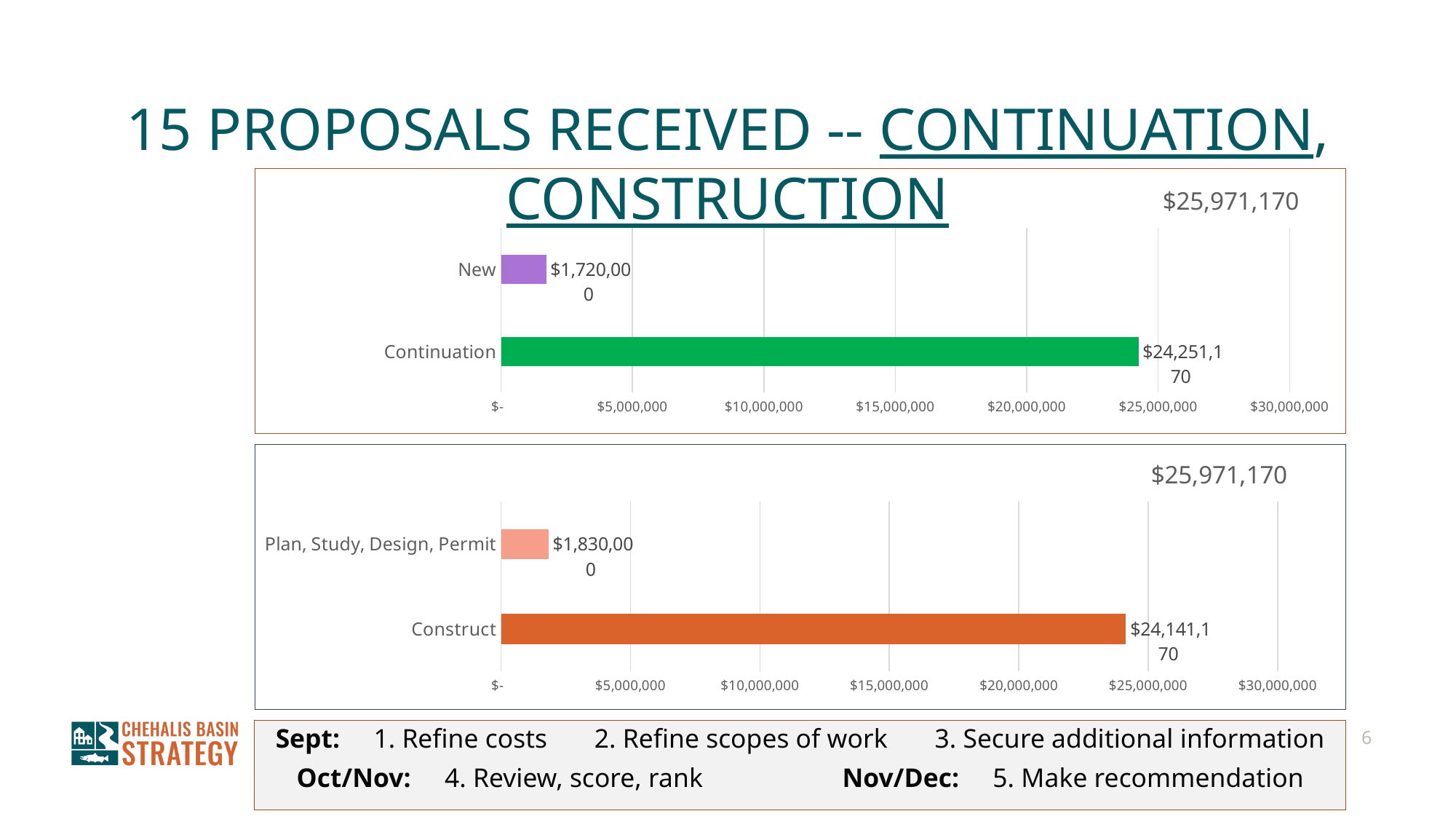
In the top chart, which category has the highest value? Continuation In the bottom chart, what is the value for Construct? $24,141,170 In the bottom chart, what is the difference between the Construct and Plan, Study, Design, Permit values? $22,311,170 In the bottom chart, which is larger, Construct or Plan, Study, Design, Permit? Construct How many categories are shown in the bottom chart? 2 In the top chart, is the value for Continuation greater or less than $20,000,000? greater In the top chart, what is the difference between the Continuation and New values? $22,531,170 In the bottom chart, which category has the lowest value? Plan, Study, Design, Permit In the top chart, what is the value for New? $1,720,000 What type of chart is the top chart? bar chart In the top chart, what is the value for Continuation? $24,251,170 In the bottom chart, what is the value for Plan, Study, Design, Permit? $1,830,000